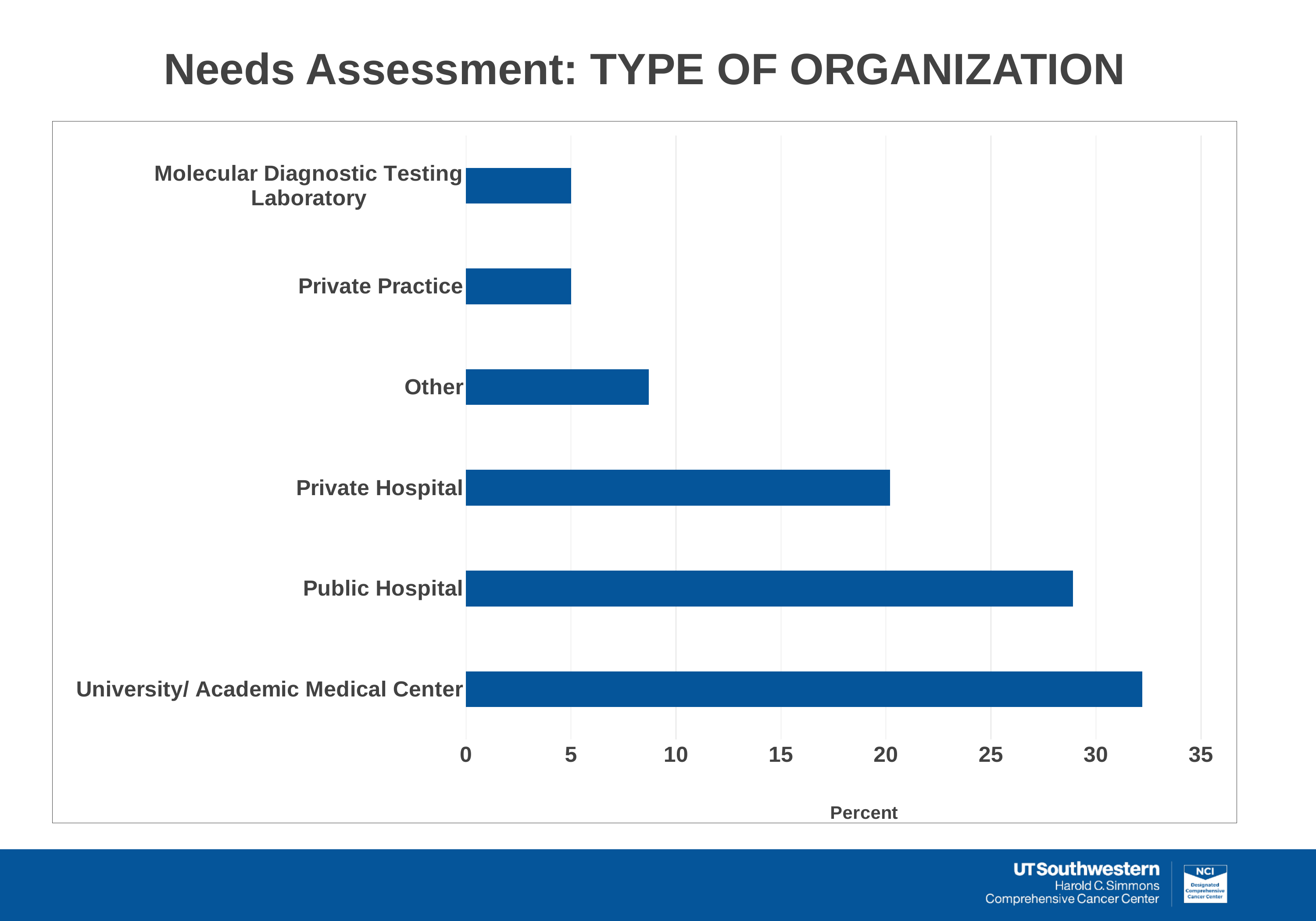
Is the value for University/ Academic Medical Center greater or less than 30? greater Is the value for Public Hospital greater or less than 30? less What is the label on the horizontal axis of the chart? Percent Which has a larger value, Other or Private Practice? Other Is the value for Other greater or less than 5? greater Which has a larger value, Public Hospital or Private Hospital? Public Hospital What type of chart is shown on the slide? bar chart How many organization types are shown in the chart? 6 Which organization type has the highest percentage? University/ Academic Medical Center